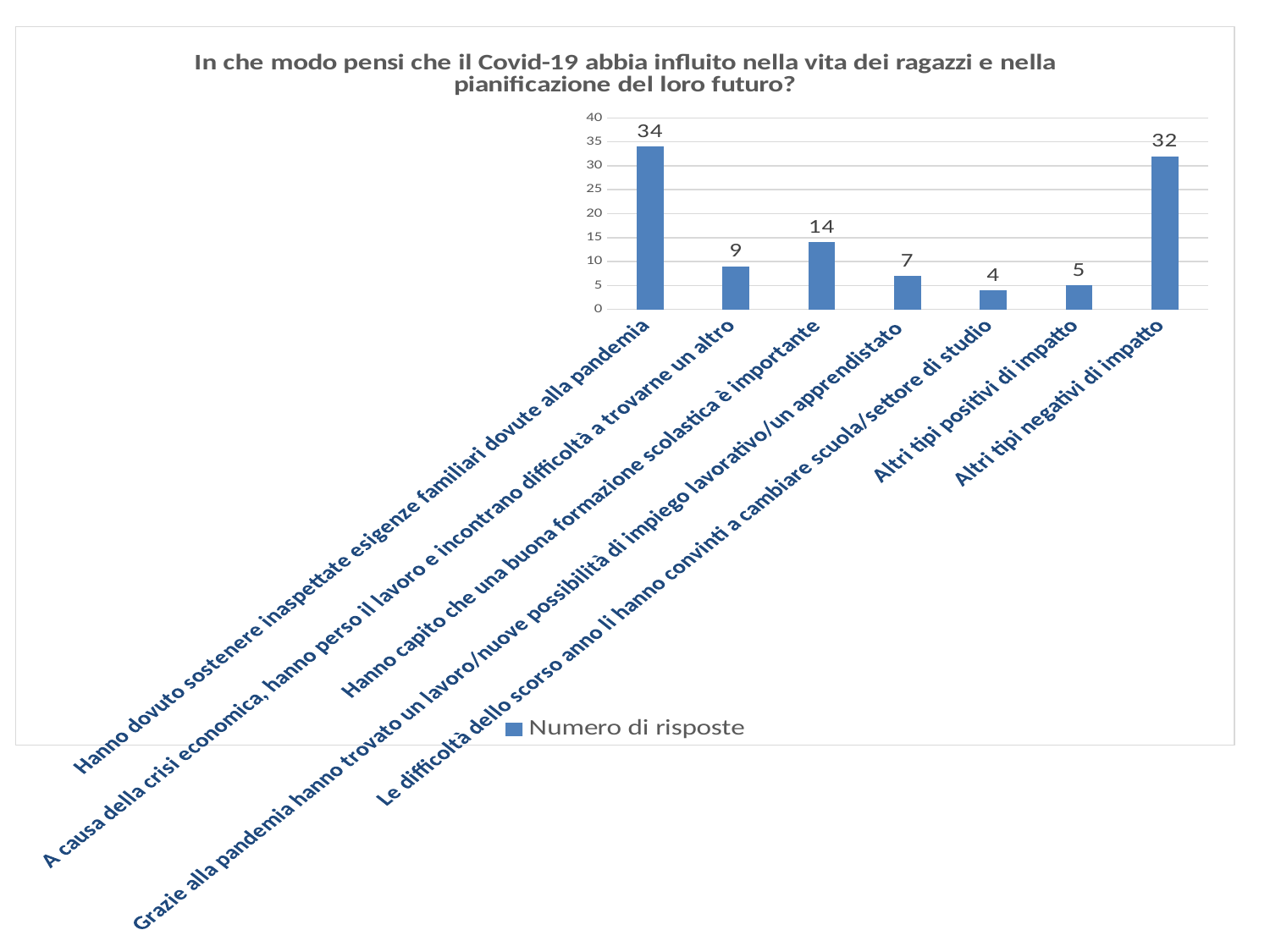
Which category has the highest value? Hanno dovuto sostenere inaspettate esigenze familiari dovute alla pandemia Which is larger: the value for "A causa della crisi economica, hanno perso il lavoro e incontrano difficoltà a trovarne un altro" or the value for "Grazie alla pandemia hanno trovato un lavoro/nuove possibilità di impiego lavorativo/un apprendistato"? A causa della crisi economica, hanno perso il lavoro e incontrano difficoltà a trovarne un altro What is the value for "Altri tipi positivi di impatto"? 5 What is the difference between the values for "Hanno dovuto sostenere inaspettate esigenze familiari dovute alla pandemia" and "Altri tipi negativi di impatto"? 2 What is the name of the series shown in the legend? Numero di risposte Which category has the lowest value? Le difficoltà dello scorso anno li hanno convinti a cambiare scuola/settore di studio What is the value for "Hanno capito che una buona formazione scolastica è importante"? 14 What is the value for "Altri tipi negativi di impatto"? 32 What is the difference between the values for "Hanno capito che una buona formazione scolastica è importante" and "A causa della crisi economica, hanno perso il lavoro e incontrano difficoltà a trovarne un altro"? 5 What kind of chart is shown on the slide? Bar chart How many categories are shown on the x axis? 7 How many series does the legend list? 1